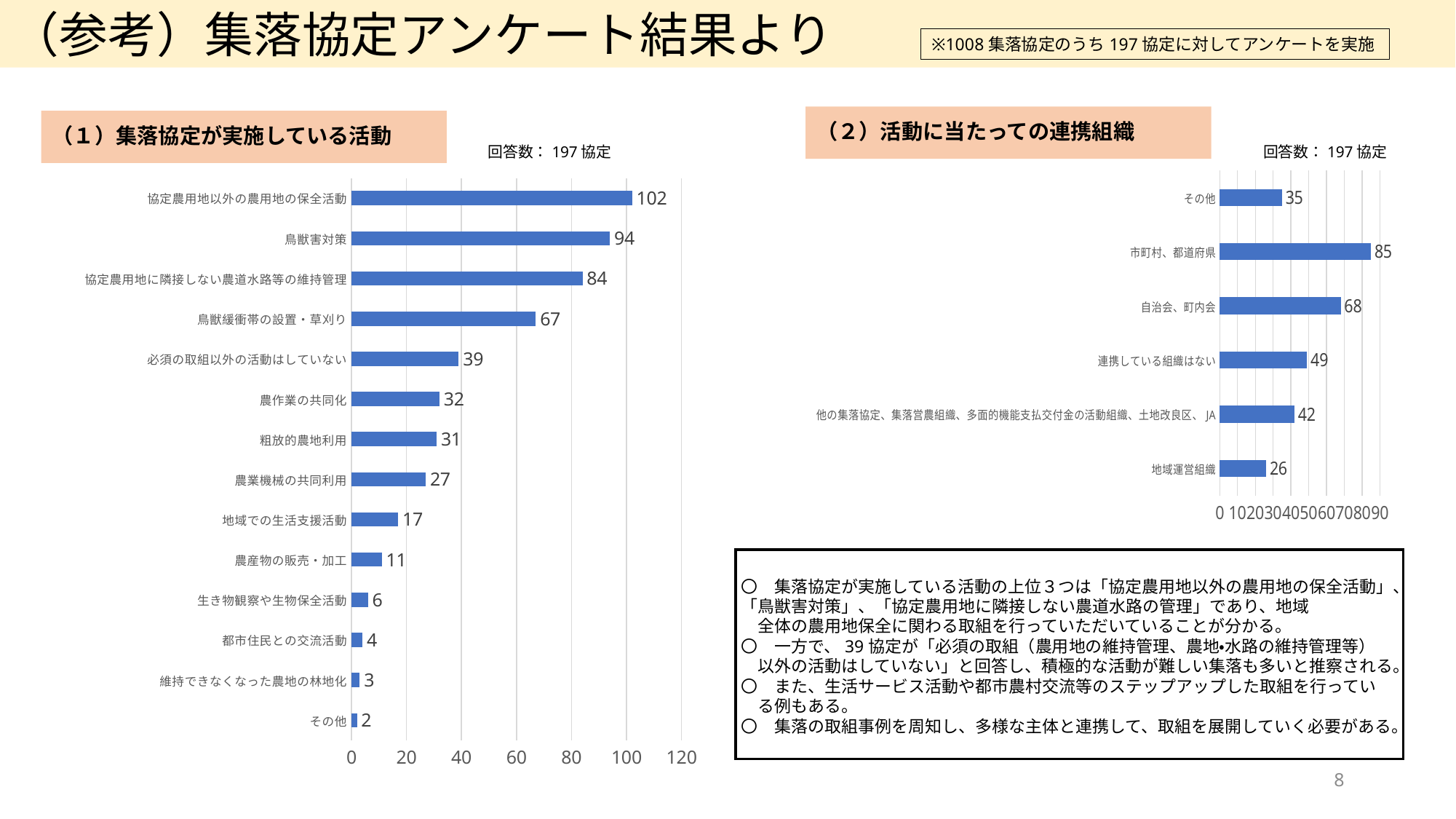
In the chart titled （２）活動に当たっての連携組織, how many categories are shown? 6 In the chart titled （２）活動に当たっての連携組織, which category has the lowest value? 地域運営組織 In the chart titled （１）集落協定が実施している活動, which category has the lowest value? その他 In the chart titled （１）集落協定が実施している活動, what is the value for 鳥獣害対策? 94 In the chart titled （２）活動に当たっての連携組織, which category has the highest value? 市町村、都道府県 In the chart titled （１）集落協定が実施している活動, what is the difference between the values for 協定農用地以外の農用地の保全活動 and 鳥獣緩衝帯の設置・草刈り? 35 In the chart titled （２）活動に当たっての連携組織, which is larger: the value for 連携している組織はない or the value for その他? 連携している組織はない In the chart titled （１）集落協定が実施している活動, what is the value for 必須の取組以外の活動はしていない? 39 In the chart titled （２）活動に当たっての連携組織, what is the value for 自治会、町内会? 68 In the chart titled （１）集落協定が実施している活動, which category has the highest value? 協定農用地以外の農用地の保全活動 In the chart titled （１）集落協定が実施している活動, how many categories are shown? 14 What type of chart is the chart titled （２）活動に当たっての連携組織? Bar chart